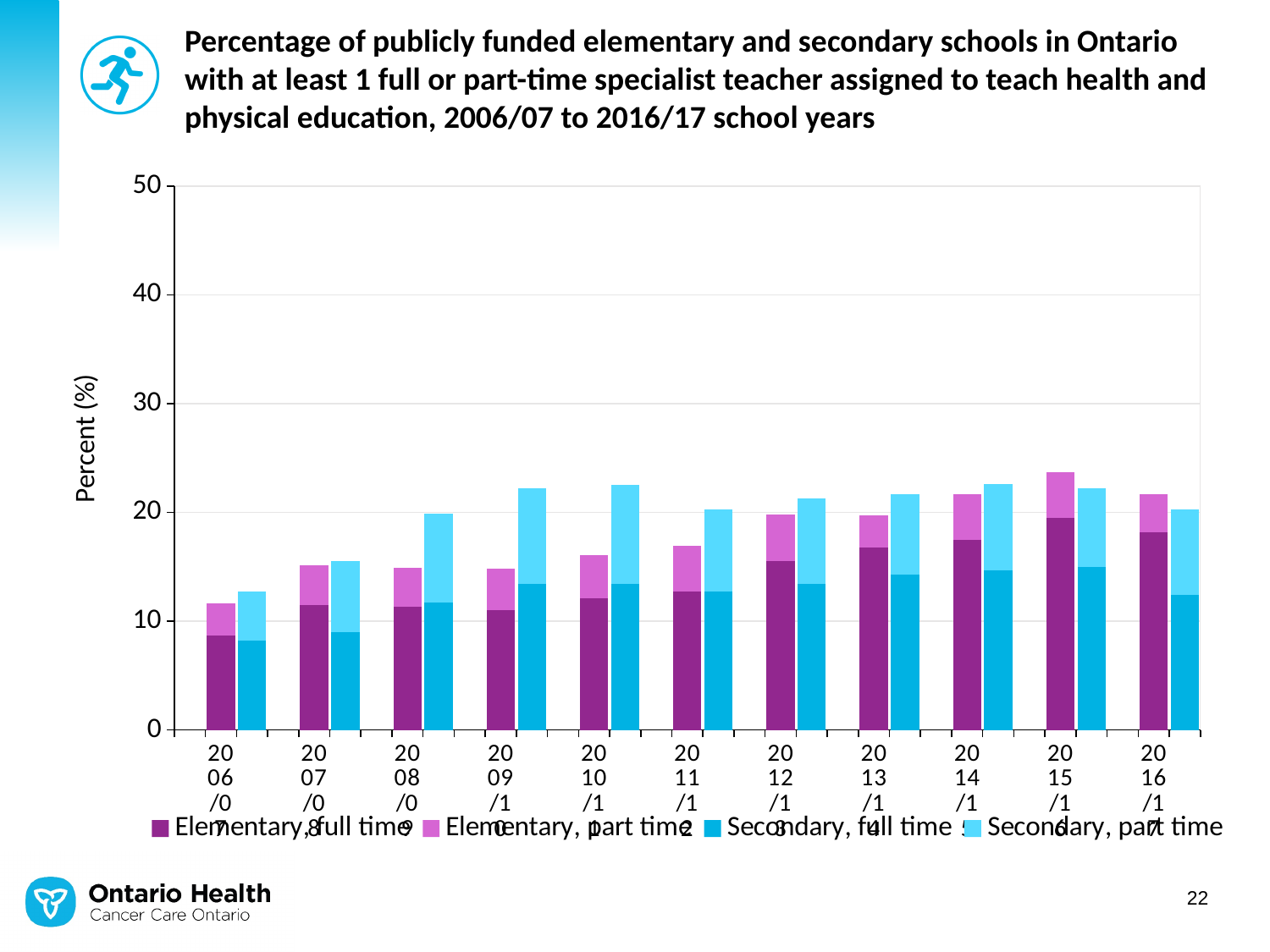
In which school year is the total of the elementary stacked bar the highest? 2015/16 In which school year is the total of the secondary stacked bar the lowest? 2006/07 Is the total of the elementary stacked bar for 2006/07 greater or less than 20? less Is the value for Elementary, full time in 2016/17 greater or less than 10? greater Is the total of the secondary stacked bar for 2009/10 greater or less than 20? greater What kind of chart is shown on the slide? stacked bar chart What is the label of the y axis? Percent (%) How many school years are shown on the x axis? 11 Which series is shown in dark purple according to the legend? Elementary, full time Does the value for Elementary, full time generally rise or fall from 2006/07 to 2016/17? rise How many series does the legend list? 4